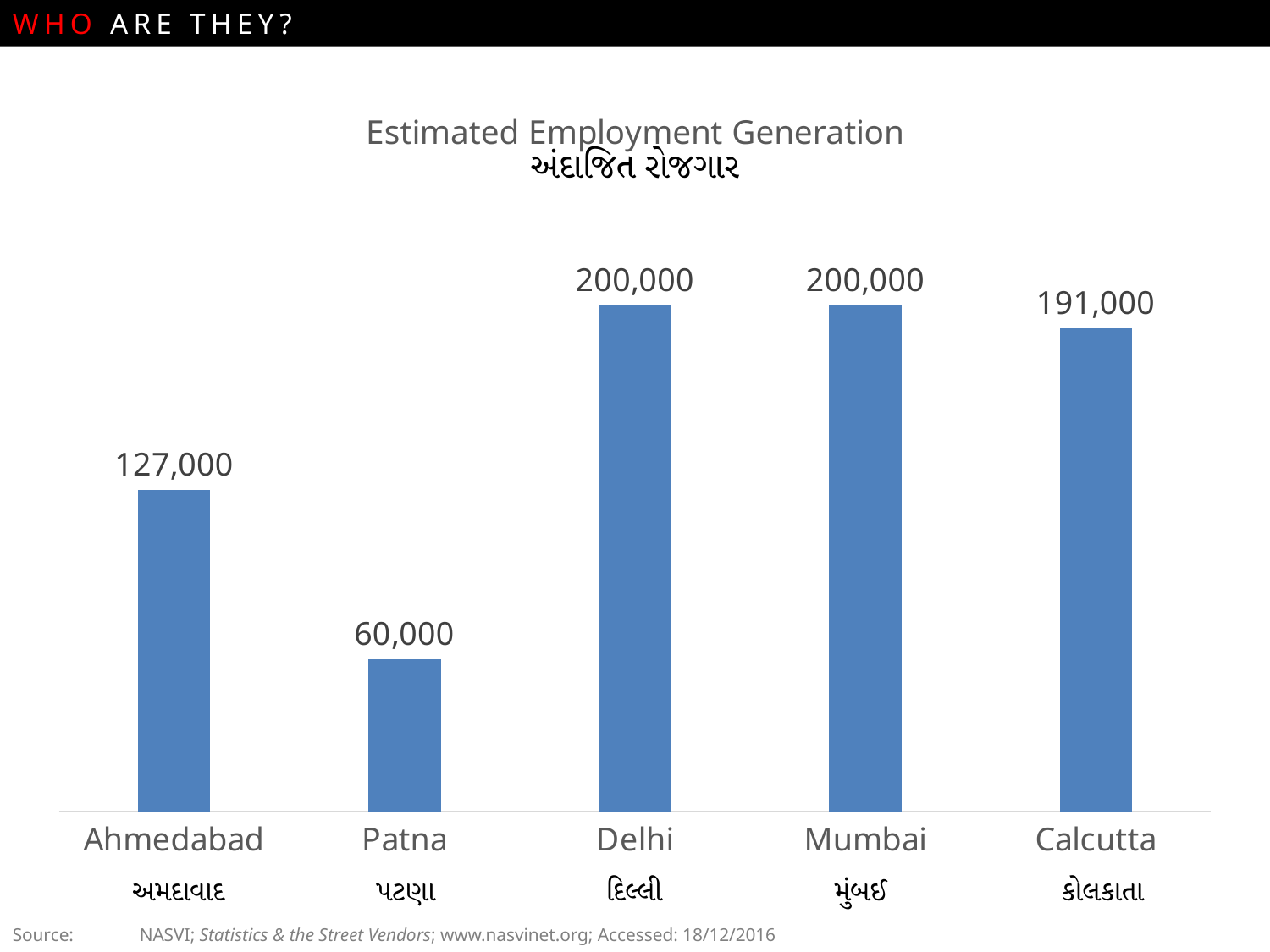
How many cities are shown in the chart? 5 Which city has the lowest estimated employment generation? Patna What type of chart is shown on the slide? Bar chart What is the estimated employment generation for Ahmedabad? 127,000 What is the estimated employment generation for Patna? 60,000 Which has a higher estimated employment generation, Ahmedabad or Calcutta? Calcutta What is the difference in estimated employment generation between Mumbai and Calcutta? 9,000 What is the title of the chart? Estimated Employment Generation What is the estimated employment generation for Delhi? 200,000 What is the difference in estimated employment generation between Delhi and Patna? 140,000 What is the estimated employment generation for Calcutta? 191,000 Which has a higher estimated employment generation, Patna or Ahmedabad? Ahmedabad